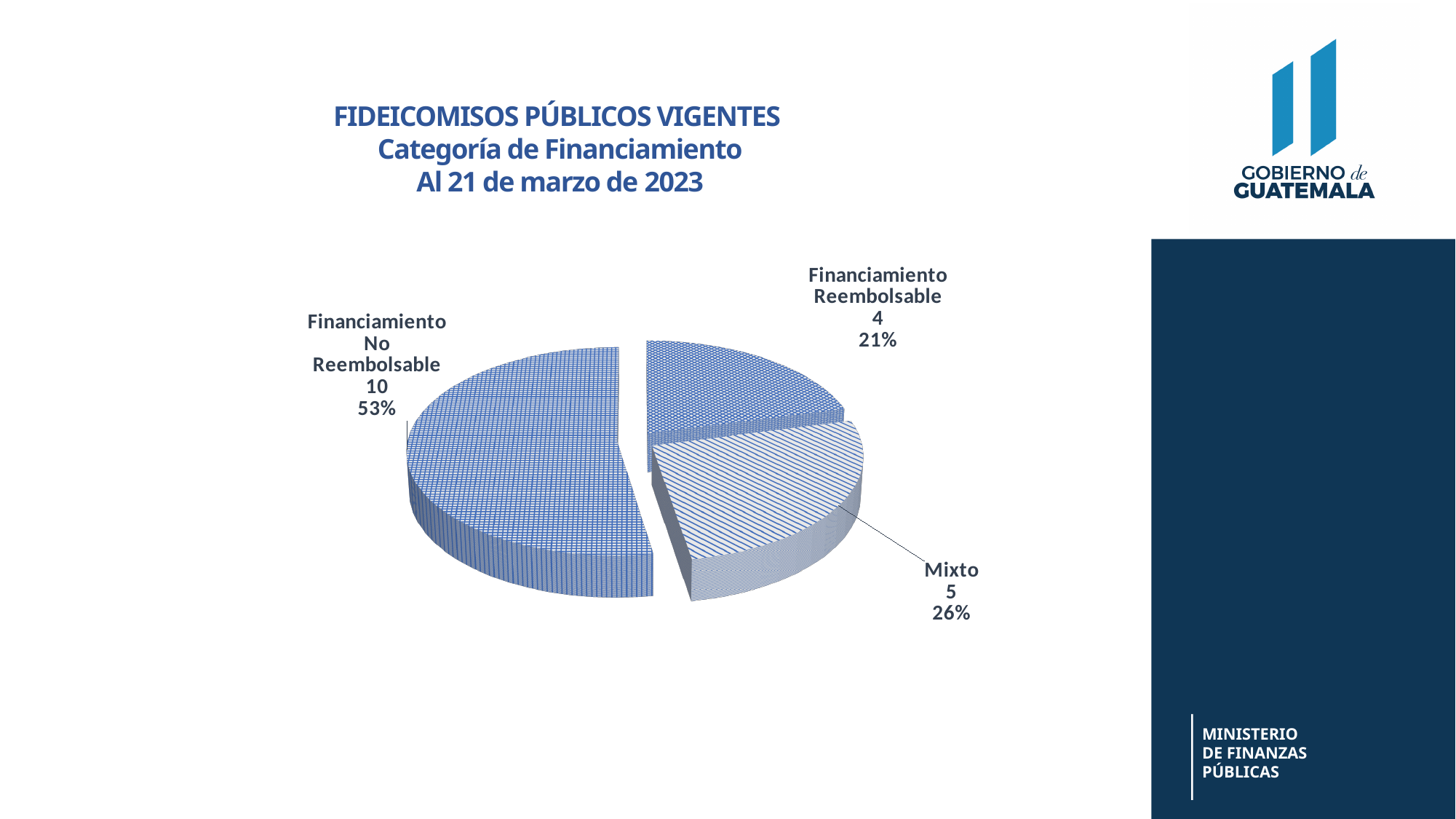
How many fideicomisos are in the Financiamiento No Reembolsable category? 10 What is the difference in count between Financiamiento No Reembolsable and Mixto? 5 What percentage share does the Financiamiento Reembolsable slice represent? 21% How many fideicomisos are in the Mixto category? 5 Which category has the largest slice of the pie? Financiamiento No Reembolsable Which category has the smallest slice of the pie? Financiamiento Reembolsable Which is larger, the Mixto count or the Financiamiento Reembolsable count? Mixto What kind of chart is shown on the slide? Pie chart How many categories does the pie chart show? 3 How many fideicomisos are in the Financiamiento Reembolsable category? 4 What percentage share does the Mixto slice represent? 26% What percentage share does the Financiamiento No Reembolsable slice represent? 53%